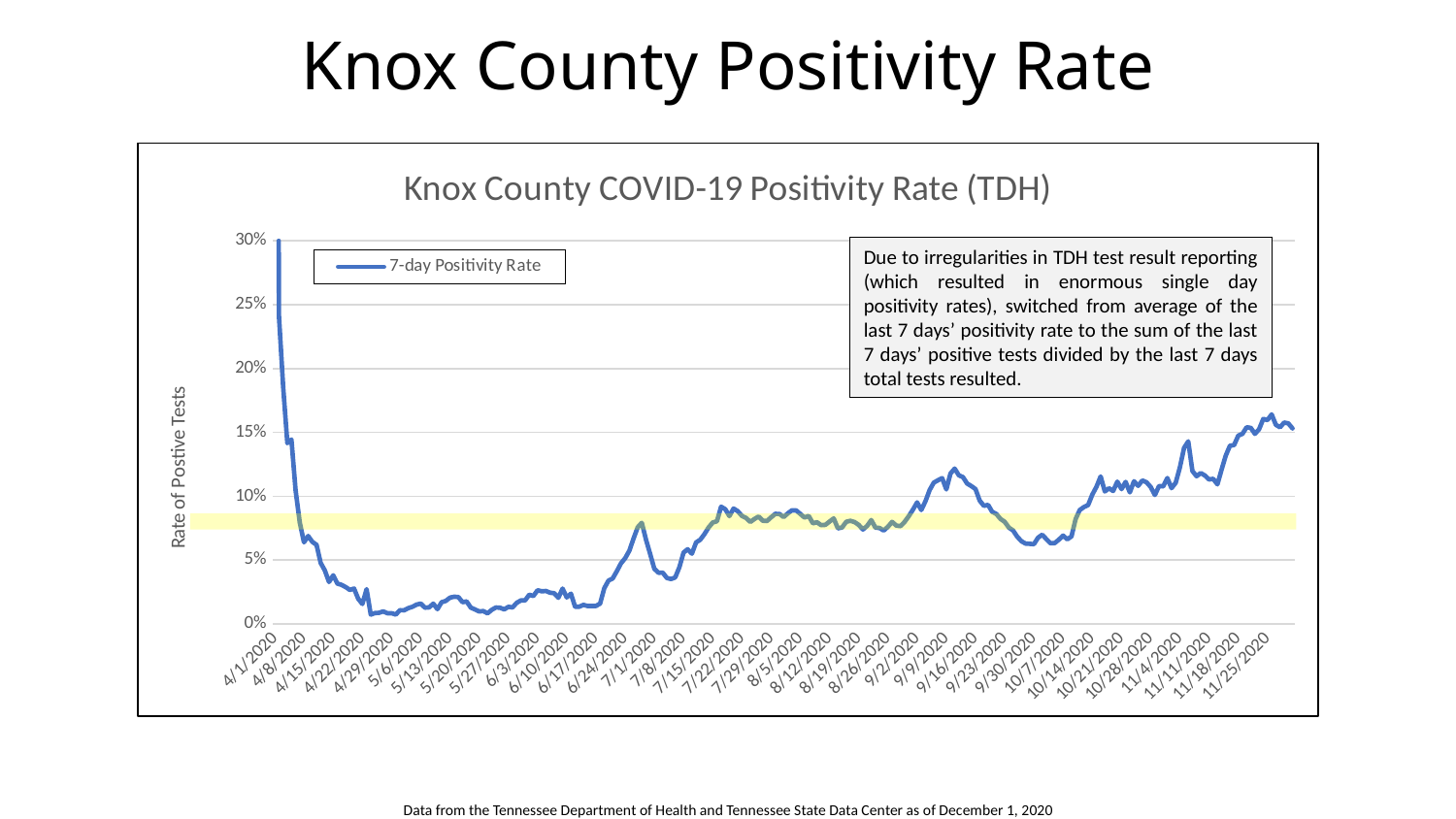
Is the 7-day positivity rate on 11/25/2020 greater or less than 10%? greater How many series does the chart legend list? 1 Does the 7-day positivity rate rise or fall between 10/7/2020 and 11/25/2020? rise Is the 7-day positivity rate on 4/1/2020 greater or less than 25%? greater What kind of chart is shown on the slide? line chart What is the title of the chart? Knox County COVID-19 Positivity Rate (TDH) Is the 7-day positivity rate on 10/7/2020 greater or less than 10%? less What series name is shown in the chart legend? 7-day Positivity Rate Does the 7-day positivity rate rise or fall between 4/1/2020 and 4/29/2020? fall